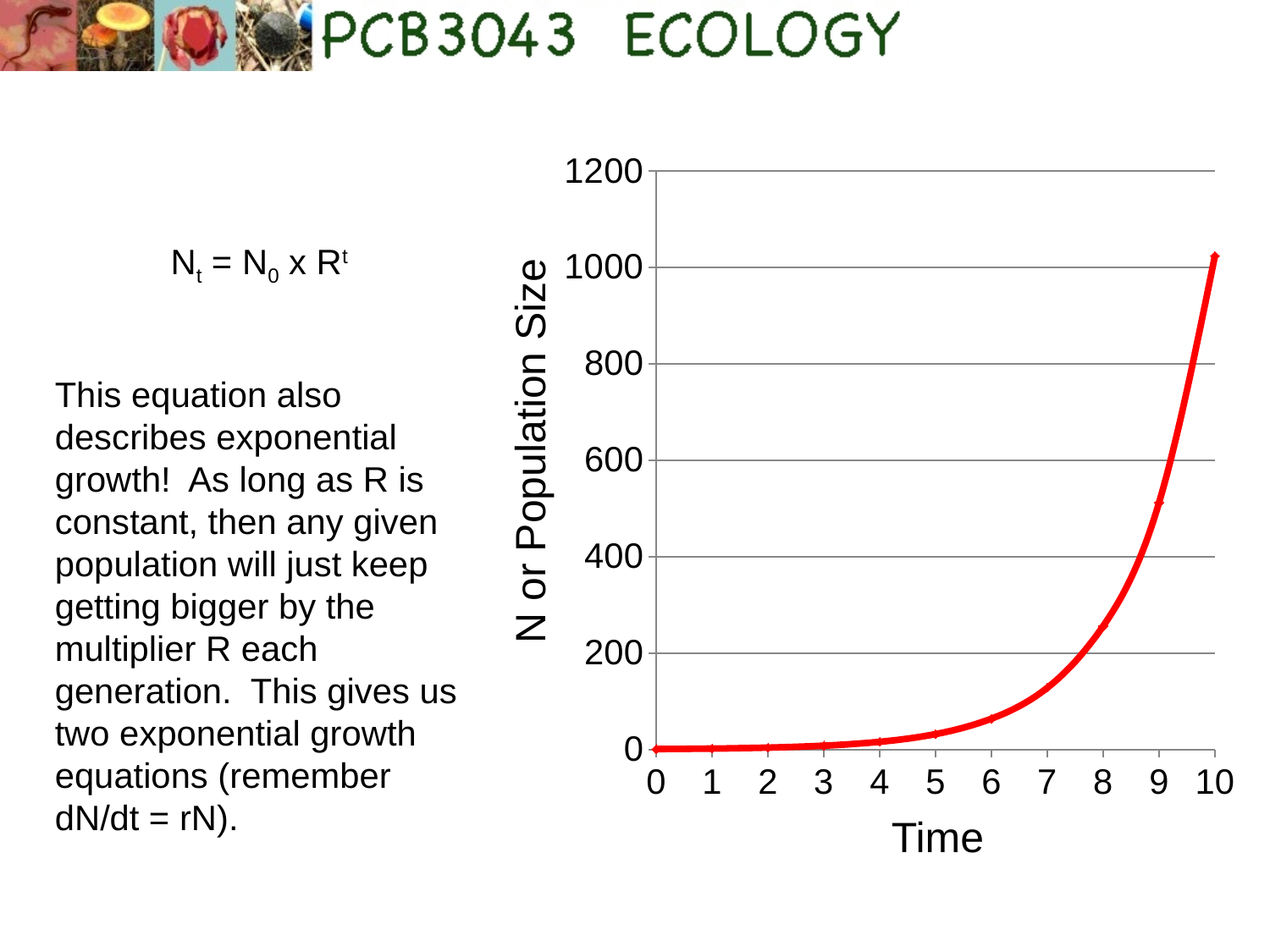
At which Time value is the population size highest? 10 What is the label of the x axis of the chart? Time Is the population size at Time 9 greater or less than 600? less Is the population size at Time 9 greater or less than 400? greater Is the population size at Time 8 greater or less than 400? less What kind of chart is shown on the slide? line chart At which Time value is the population size lowest? 0 What is the label of the y axis of the chart? N or Population Size How many data points are plotted on the line? 11 Do the plotted values rise or fall as Time increases? rise